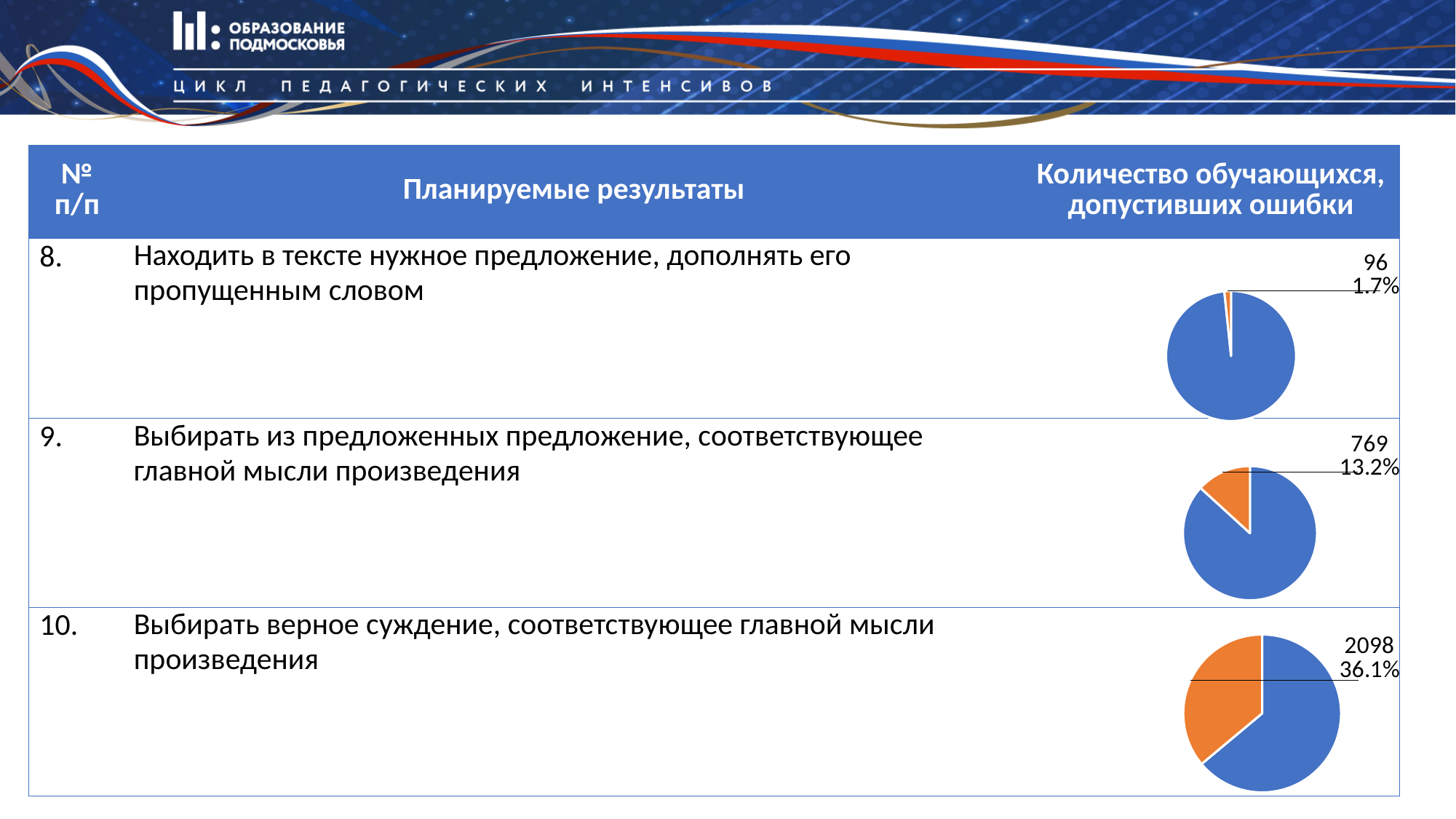
In the pie chart for row 10 (bottom chart), what percentage is shown for the orange slice? 36.1% In the pie chart for row 8 (top chart), what value is printed on the orange slice's data label? 96 What type of chart is shown in row 8 of the table? pie chart Is the labelled value in the row 9 pie chart larger or smaller than the labelled value in the row 8 pie chart? larger In the pie chart for row 8 (top chart), what percentage is shown for the orange slice? 1.7% In the pie chart for row 9 (middle chart), what share does the orange slice represent? 13.2% In the pie chart for row 9 (middle chart), what number of students is shown on the data label? 769 What is the difference between the labelled values in the row 10 pie chart (2098) and the row 9 pie chart (769)? 1329 In the pie chart for row 10 (bottom chart), what number is printed on the data label? 2098 How many pie charts are shown on the slide? 3 Which row's pie chart shows the smallest orange slice: row 8, row 9 or row 10? row 8 Which row's pie chart shows the largest orange slice: row 8, row 9 or row 10? row 10